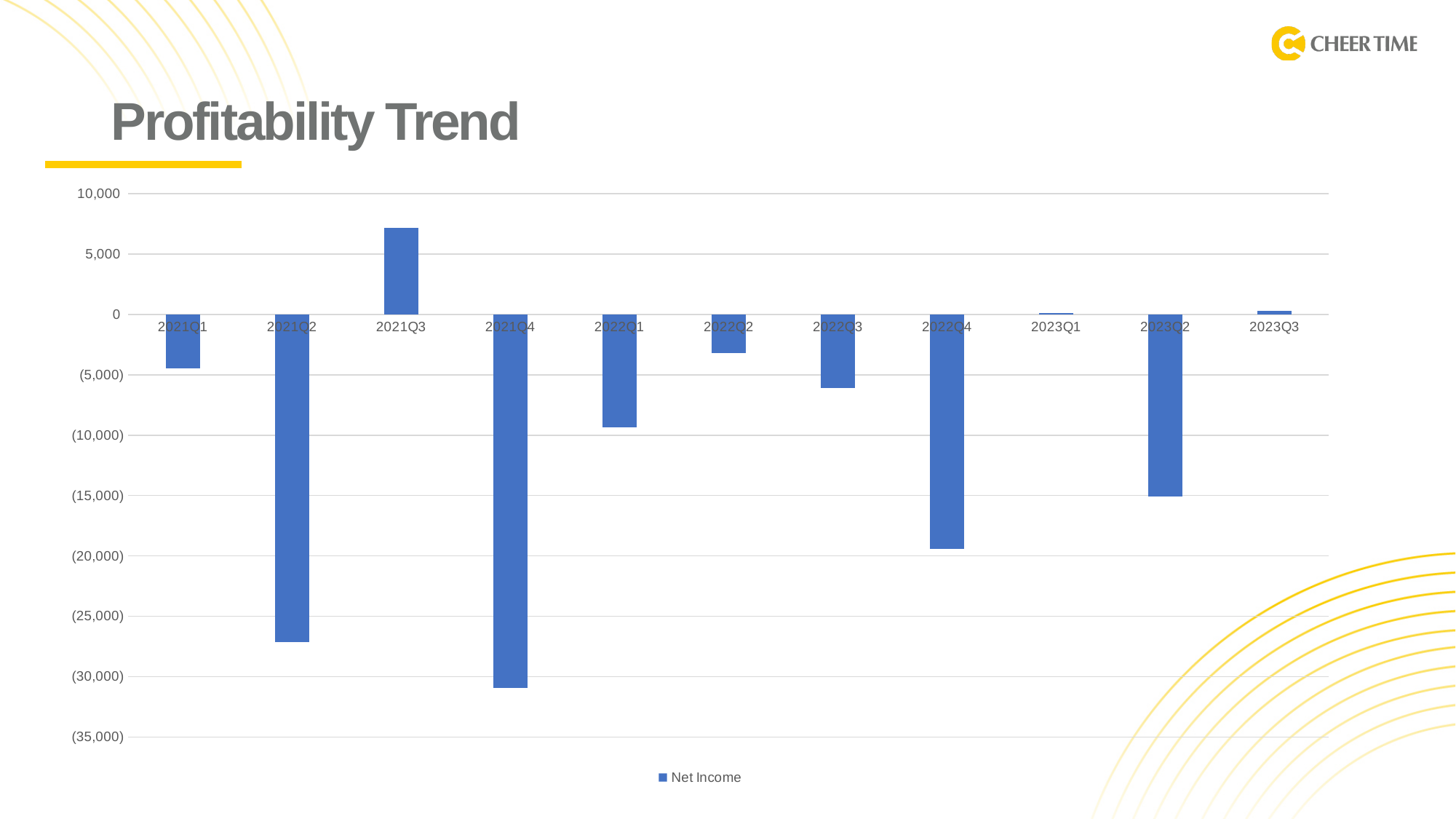
What kind of chart is shown on the slide? bar chart Is the Net Income for 2021Q2 greater or less than (25,000)? less Is the Net Income for 2022Q1 greater or less than (10,000)? greater What is the name of the series shown in the legend? Net Income How many quarters are plotted on the x axis? 11 Is the Net Income for 2021Q3 greater or less than 5,000? greater How many series does the legend list? 1 Which quarter has the highest Net Income? 2021Q3 Which quarter has the larger Net Income, 2022Q1 or 2022Q2? 2022Q2 Which quarter has the lowest Net Income? 2021Q4 What is the title of the slide containing the chart? Profitability Trend